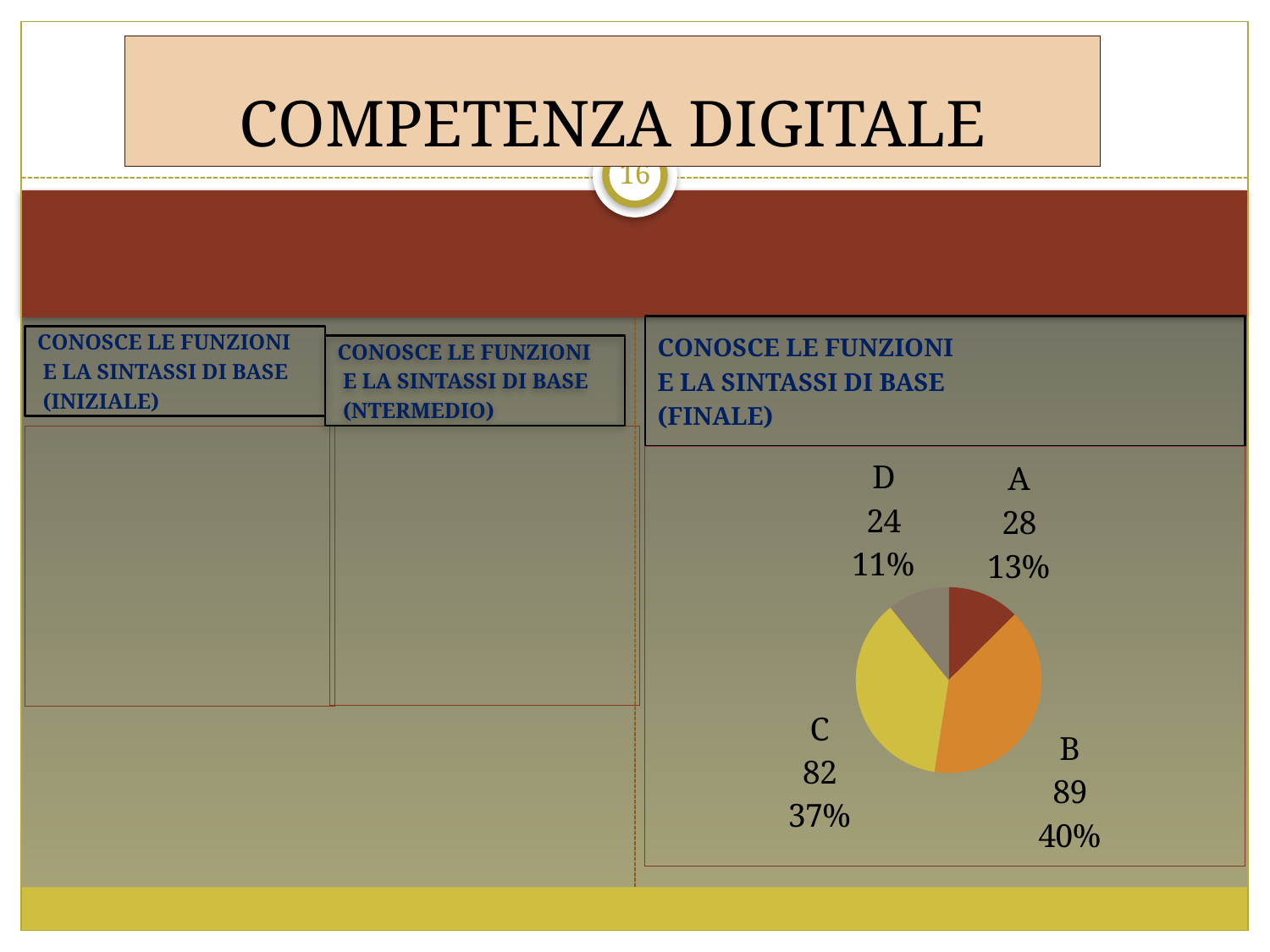
In the pie chart, what is the value for category D? 24 Which category has the smallest slice in the pie chart? D Which category has the largest slice in the pie chart? B What is the total of all the values shown in the pie chart? 223 In the pie chart, which is larger, the value for A or the value for C? C In the pie chart, what percentage share does category C have? 37% In the pie chart, what percentage share does category A have? 13% In the pie chart, what is the value for category B? 89 How many categories are shown in the pie chart? 4 What kind of chart is shown under "CONOSCE LE FUNZIONI E LA SINTASSI DI BASE (FINALE)"? pie chart What is the difference between the values for A and D in the pie chart? 4 What is the difference between the values for B and C in the pie chart? 7